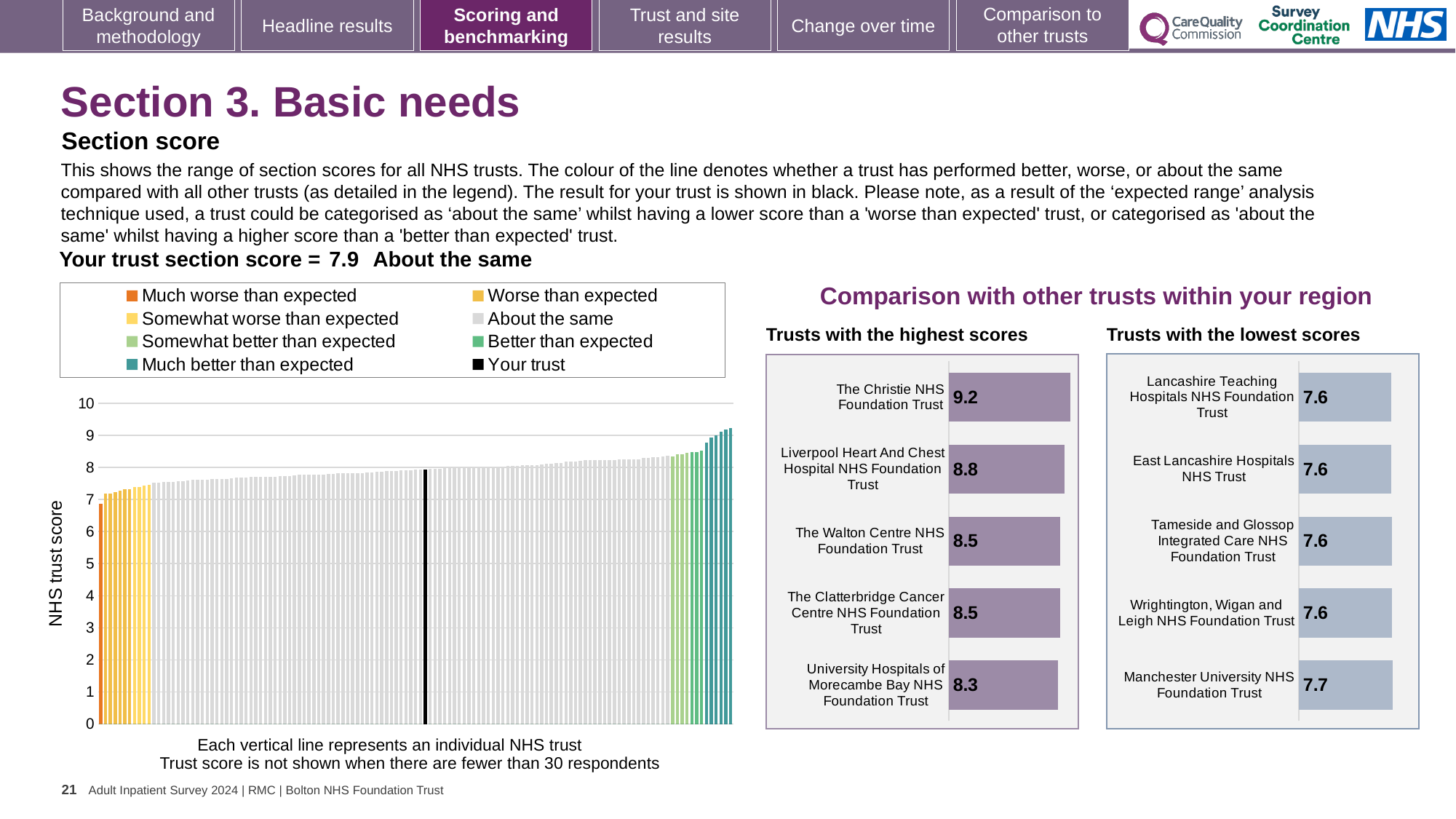
In the 'Trusts with the lowest scores' chart, which trust has the highest score? Manchester University NHS Foundation Trust In the large chart on the left, how many entries does the legend list? 8 In the large chart on the left, do the trust scores rise or fall from left to right? rise According to the slide, what is your trust's section score for Basic needs? 7.9 What kind of chart is the large chart on the left showing NHS trust scores? bar chart In the 'Trusts with the lowest scores' chart, what is the score for Manchester University NHS Foundation Trust? 7.7 In the 'Trusts with the highest scores' chart, which trust has the lowest score? University Hospitals of Morecambe Bay NHS Foundation Trust Which is larger: the score for The Walton Centre NHS Foundation Trust in the highest scores chart or the score for East Lancashire Hospitals NHS Trust in the lowest scores chart? The Walton Centre NHS Foundation Trust In the 'Trusts with the highest scores' chart, what is the difference between the scores of The Christie NHS Foundation Trust and Liverpool Heart And Chest Hospital NHS Foundation Trust? 0.4 How many trusts are shown in the 'Trusts with the highest scores' chart? 5 In the large chart on the left, is the value of the tallest bar at the far right greater or less than 9? greater In the 'Trusts with the highest scores' chart, what is the score for The Christie NHS Foundation Trust? 9.2